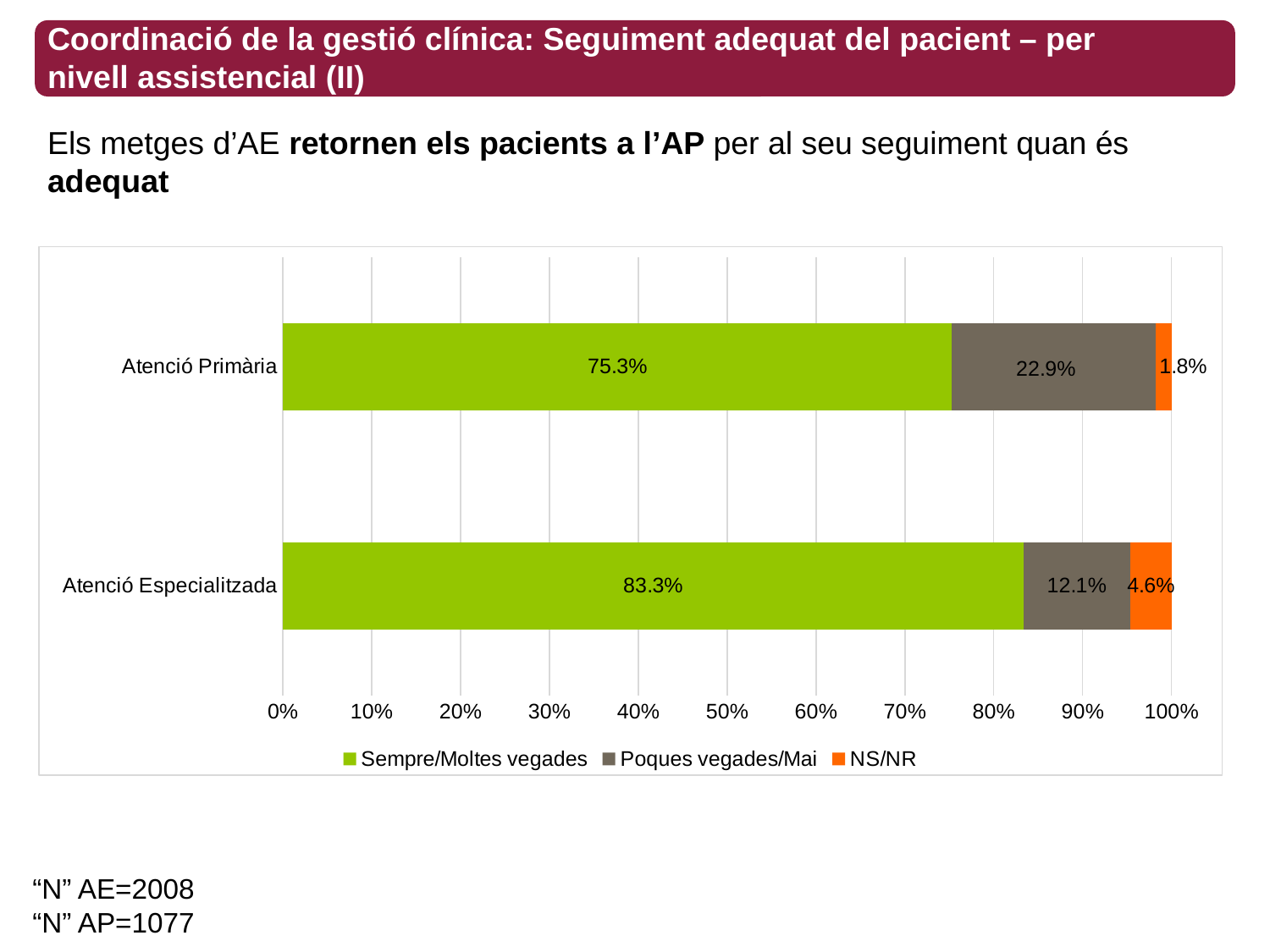
What is the NS/NR value for Atenció Especialitzada? 4.6% Is the Poques vegades/Mai value larger for Atenció Primària or Atenció Especialitzada? Atenció Primària What is the value for Sempre/Moltes vegades for Atenció Primària? 75.3% What kind of chart is shown on the slide? Stacked bar chart What is the difference between the Sempre/Moltes vegades values for Atenció Especialitzada and Atenció Primària? 8.0% Is the Sempre/Moltes vegades value for Atenció Primària greater or less than 70%? greater What is the NS/NR value for Atenció Primària? 1.8% Which category has the higher value for Sempre/Moltes vegades? Atenció Especialitzada How many categories are shown on the chart? 2 How many series does the legend list? 3 Which category has the lower value for Poques vegades/Mai? Atenció Especialitzada What is the value for Poques vegades/Mai for Atenció Especialitzada? 12.1%